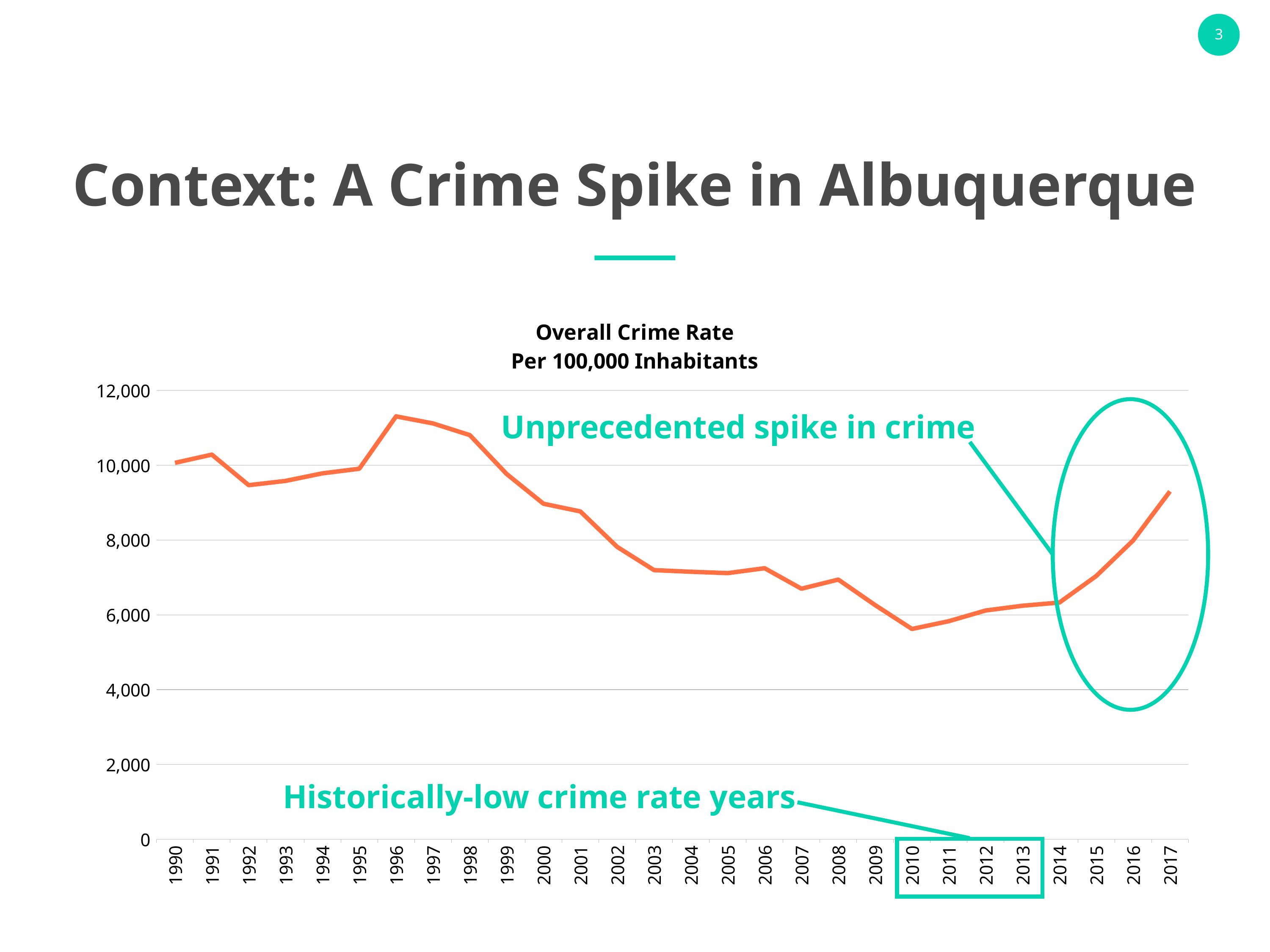
Is the value for 1996 greater or less than 10,000? greater Is the value for 2010 greater or less than 6,000? less Which year has the highest overall crime rate in the chart? 1996 What kind of chart is shown on the slide? line chart Does the crime rate rise or fall from 2014 to 2017? rise Is the value for 2003 greater or less than 8,000? less Which year has the lowest overall crime rate in the chart? 2010 Which year has a higher crime rate, 1996 or 2017? 1996 How many years are plotted along the x axis of the chart? 28 What is the title of the chart? Overall Crime Rate Per 100,000 Inhabitants Which year has a higher crime rate, 2014 or 2017? 2017